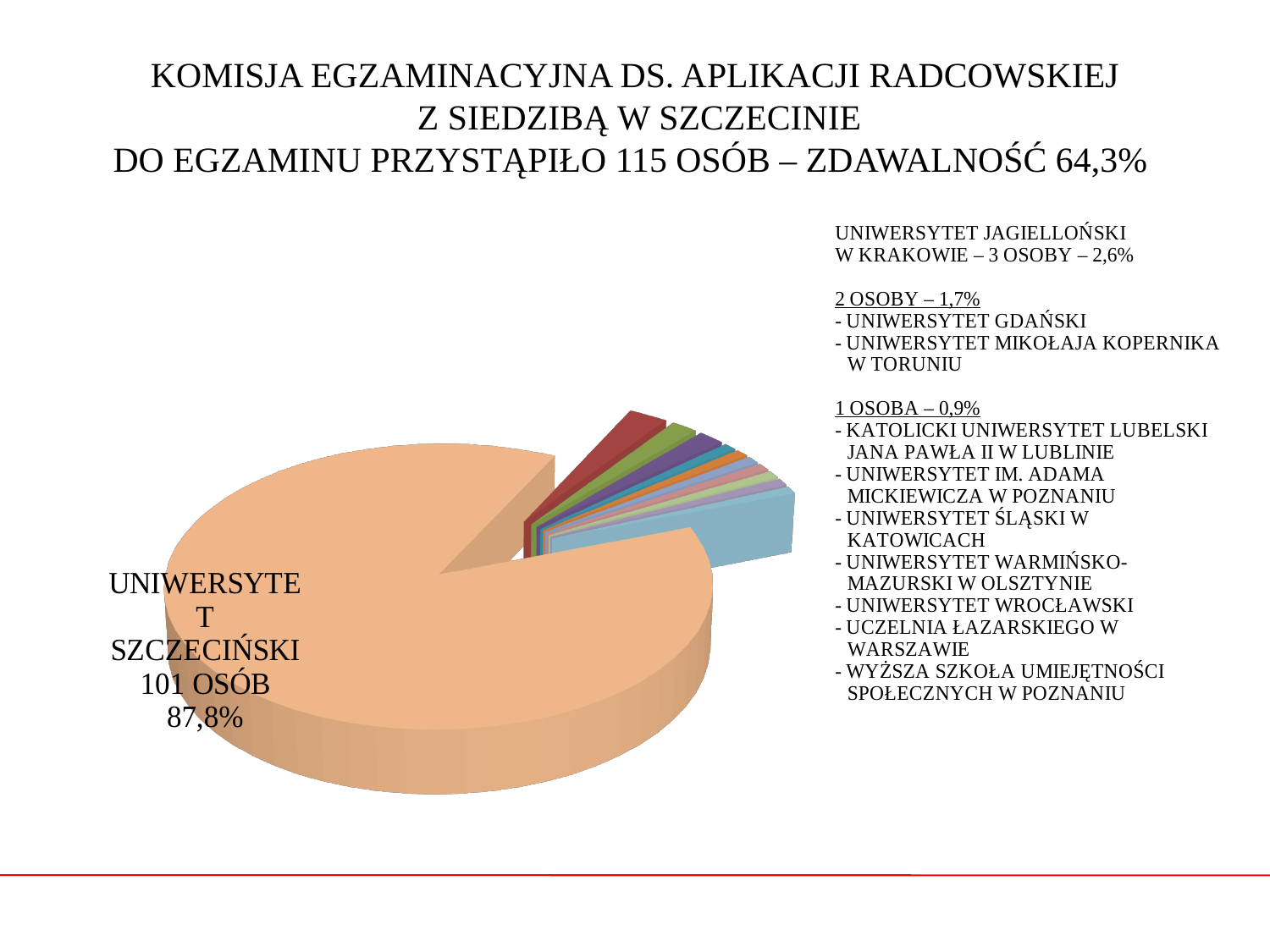
What is the difference between the number of people from Uniwersytet Szczeciński (101) and Uniwersytet Jagielloński (3)? 98 How many universities are listed on the slide as having 1 person (1 OSOBA – 0,9%)? 7 Is the share for Uniwersytet Szczeciński greater or less than 50%? greater According to the slide, how many people from Uniwersytet Jagielloński w Krakowie took the exam? 3 OSOBY What percentage share is listed for Uniwersytet Jagielloński w Krakowie? 2,6% How many people does the pie chart's largest slice, Uniwersytet Szczeciński, represent? 101 OSÓB What kind of chart is shown on the slide? Pie chart According to the slide title, how many people took the exam and what was the pass rate (zdawalność)? 115 osób – 64,3% Which university has the largest slice of the pie chart? Uniwersytet Szczeciński Which is larger: the number of people from Uniwersytet Szczeciński or from Uniwersytet Jagielloński? Uniwersytet Szczeciński What percentage share is listed for universities with 2 people (2 OSOBY)? 1,7% What share of the pie does Uniwersytet Szczeciński account for? 87,8%